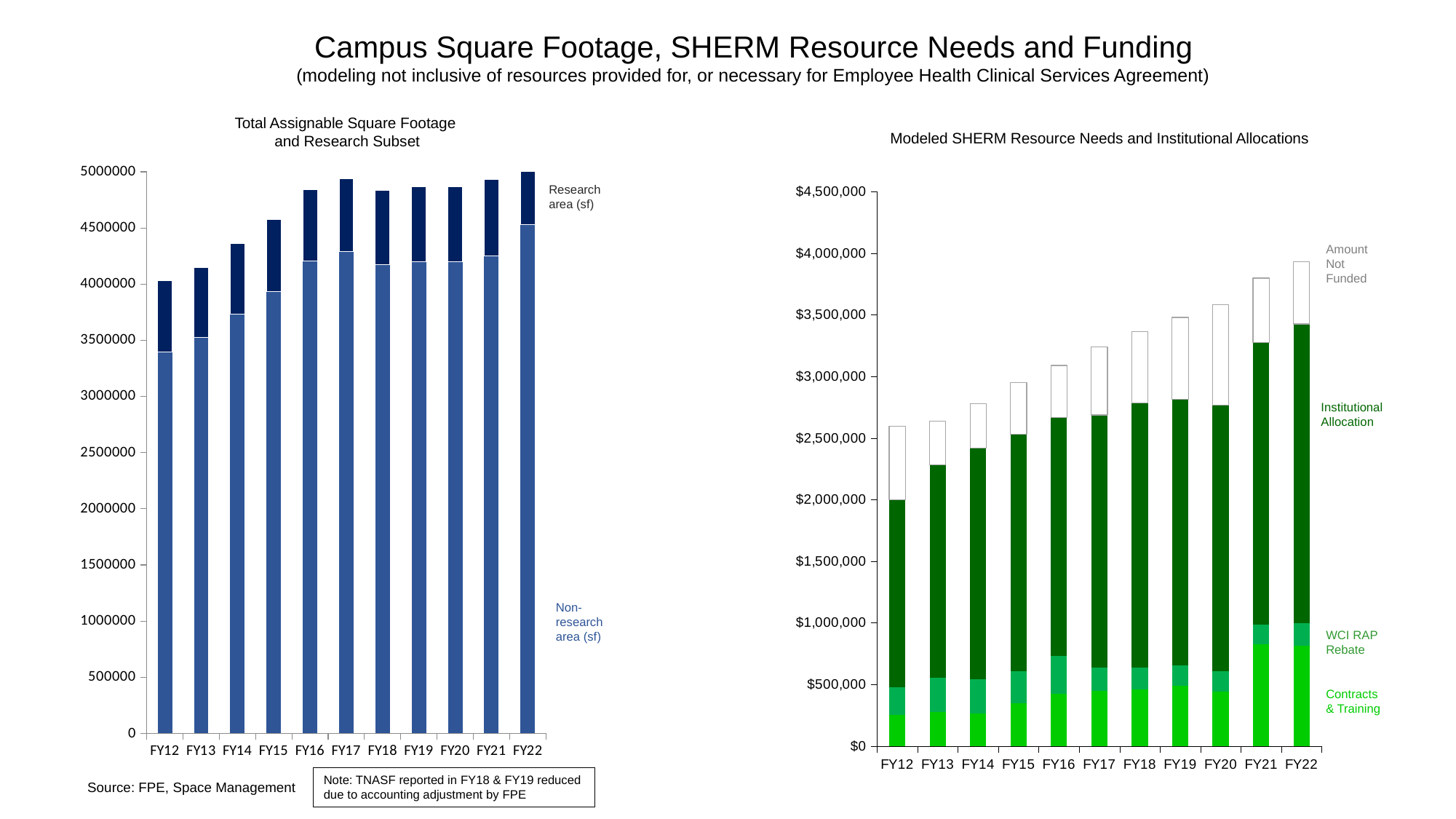
In the left chart, 'Total Assignable Square Footage and Research Subset', is the Non-research area (sf) value for FY12 greater or less than 3000000? greater What type of chart is the left chart, 'Total Assignable Square Footage and Research Subset'? Stacked bar chart In the left chart, 'Total Assignable Square Footage and Research Subset', do the total bars generally rise or fall from FY12 to FY22? Rise In the left chart, 'Total Assignable Square Footage and Research Subset', which fiscal year has the lowest total bar? FY12 In the left chart, 'Total Assignable Square Footage and Research Subset', is the total bar for FY16 greater or less than 4500000? greater In the right chart, 'Modeled SHERM Resource Needs and Institutional Allocations', is the total bar for FY22 greater or less than $4,000,000? less In the right chart, 'Modeled SHERM Resource Needs and Institutional Allocations', which series is shown at the bottom of each stacked bar? Contracts & Training How many series are shown in the left chart, 'Total Assignable Square Footage and Research Subset'? 2 How many fiscal years are shown on the x axis of the left chart, 'Total Assignable Square Footage and Research Subset'? 11 In the right chart, 'Modeled SHERM Resource Needs and Institutional Allocations', which fiscal year has the highest total bar? FY22 How many series are shown in the right chart, 'Modeled SHERM Resource Needs and Institutional Allocations'? 4